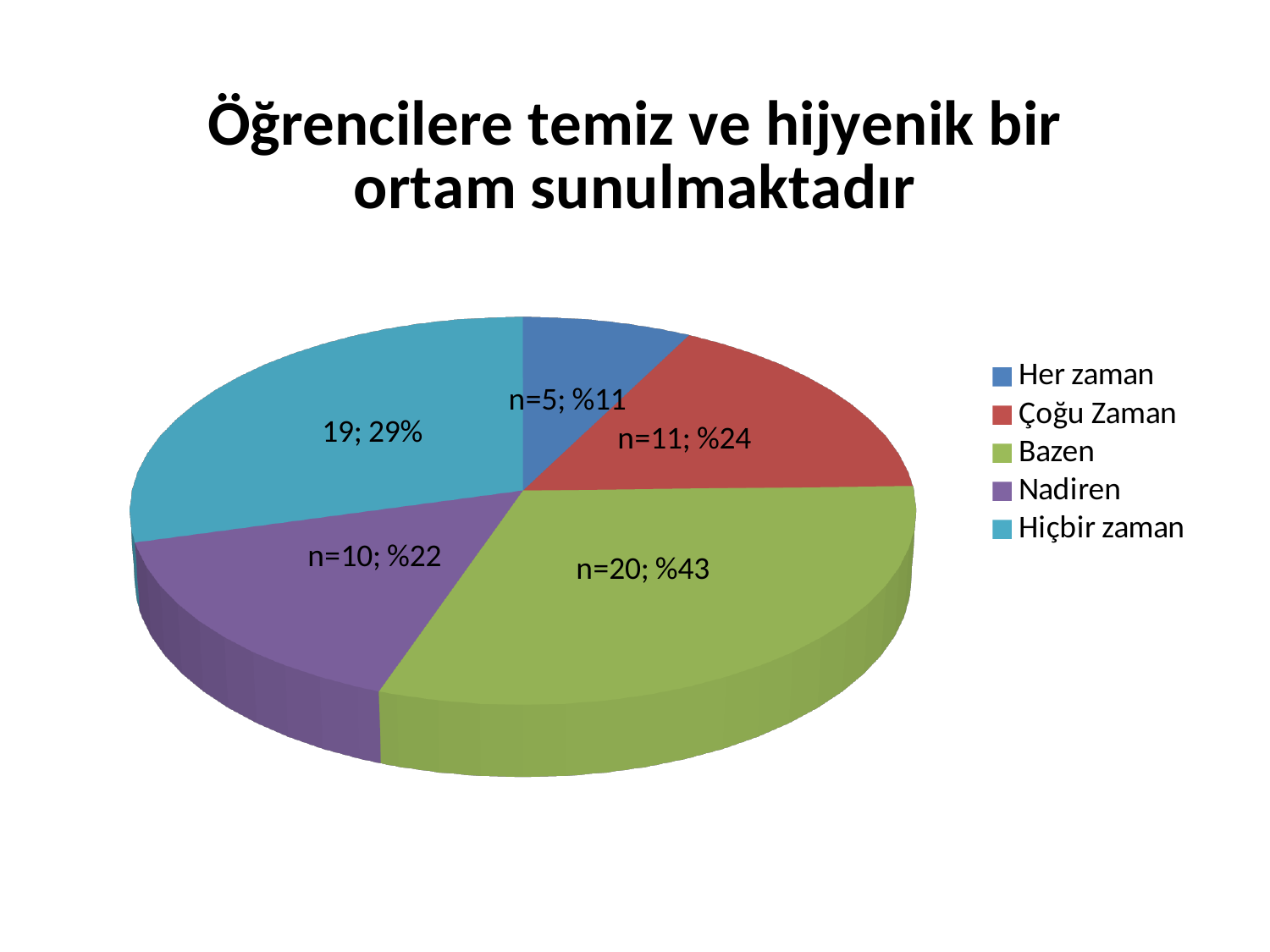
What is the difference in count between Bazen and Her zaman? 15 What is the count (n) for the Bazen slice? n=20 What is the title of the chart? Öğrencilere temiz ve hijyenik bir ortam sunulmaktadır What percentage is shown for the Her zaman slice? %11 Which has a larger count, Çoğu Zaman or Nadiren? Çoğu Zaman How many categories does the legend list? 5 What percentage is shown for the Nadiren slice? %22 What label is shown on the Hiçbir zaman slice? 19; 29% What is the count (n) for the Çoğu Zaman slice? n=11 What kind of chart is shown on the slide? Pie chart Which category has the smallest slice? Her zaman Which category has the largest slice? Bazen